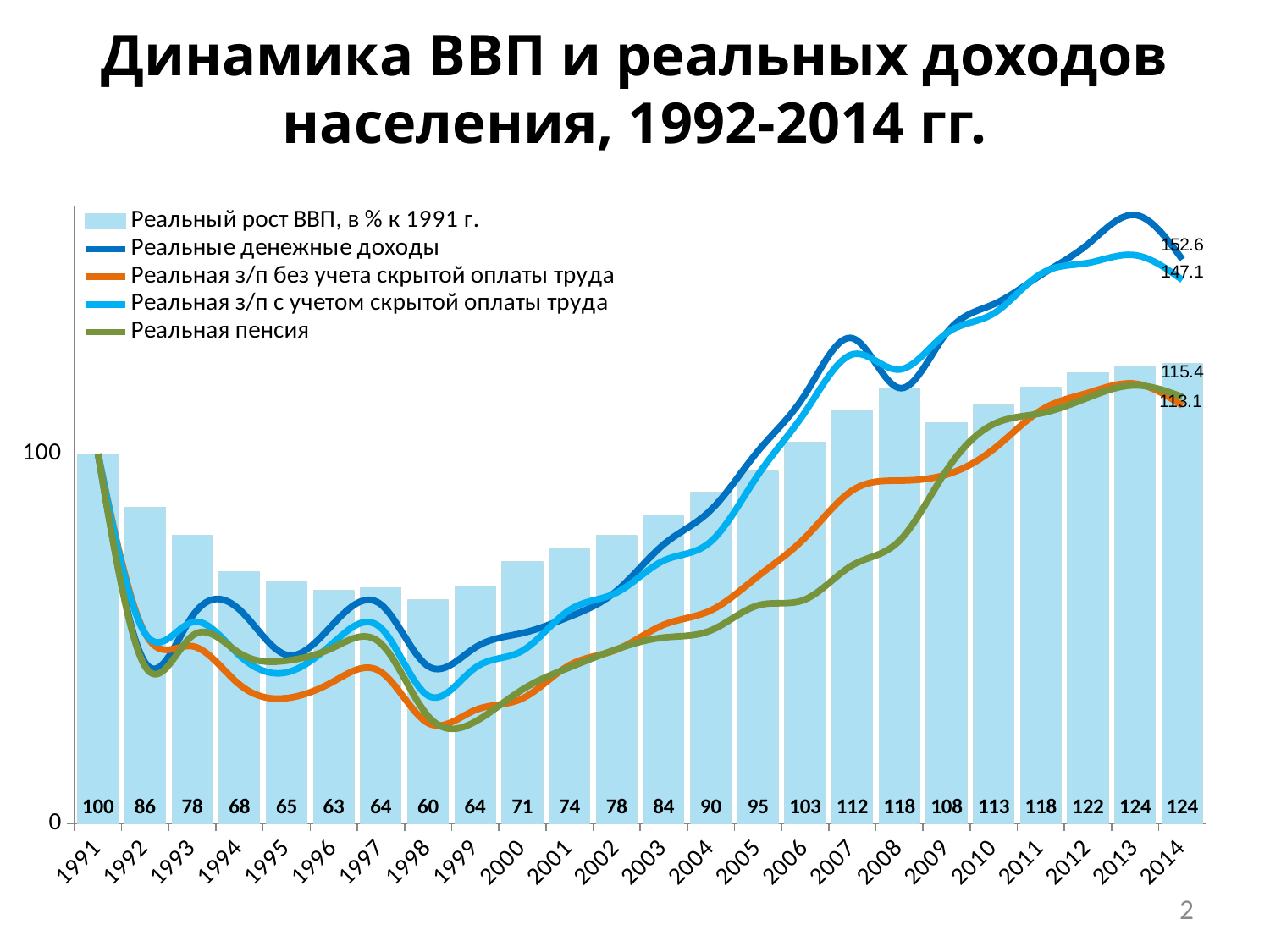
What kind of chart is shown on the slide? Combined bar and line chart Do the GDP bar values rise or fall from 1998 to 2008? Rise How many series does the legend list? 5 What is the 2014 value labelled for the Реальная пенсия line? 115.4 What is the value of the GDP bar (Реальный рост ВВП) for 1998? 60 How many years (bars) are shown on the x axis? 24 Which year has the larger GDP bar value, 2007 or 2009? 2007 What is the difference between the GDP bar values for 2008 and 2009? 10 Is the value of the Реальные денежные доходы line in 2007 greater or less than 100? greater What is the 2014 value labelled for the Реальные денежные доходы line? 152.6 In which year is the GDP bar (Реальный рост ВВП) lowest? 1998 What is the value of the GDP bar for 2013? 124